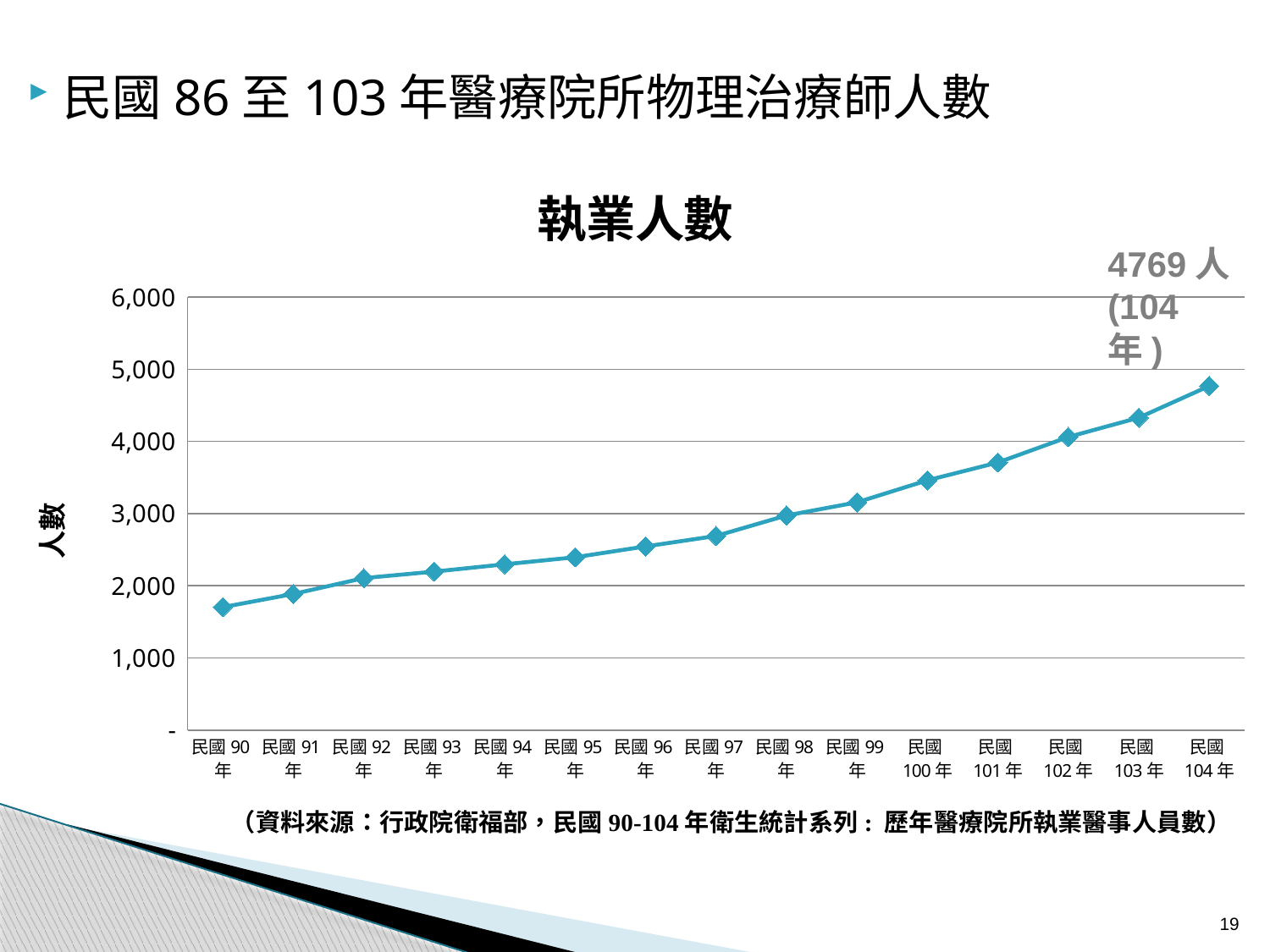
Which year has the lowest value on the chart? 民國90年 What is the label on the vertical axis of the chart? 人數 Is the value for 民國90年 greater or less than 2,000? less Which year has the highest value on the chart? 民國104年 Do the values rise or fall from 民國90年 to 民國104年? rise Is the value for 民國100年 greater or less than 3,000? greater What kind of chart is shown on the slide? line chart What is the title of the chart? 執業人數 What is the number of practising physical therapists in 民國104年 according to the annotation on the chart? 4769 人 Is the value for 民國103年 greater or less than 4,000? greater How many years (data points) are plotted on the chart? 15 Which is larger, the value for 民國99年 or the value for 民國93年? 民國99年